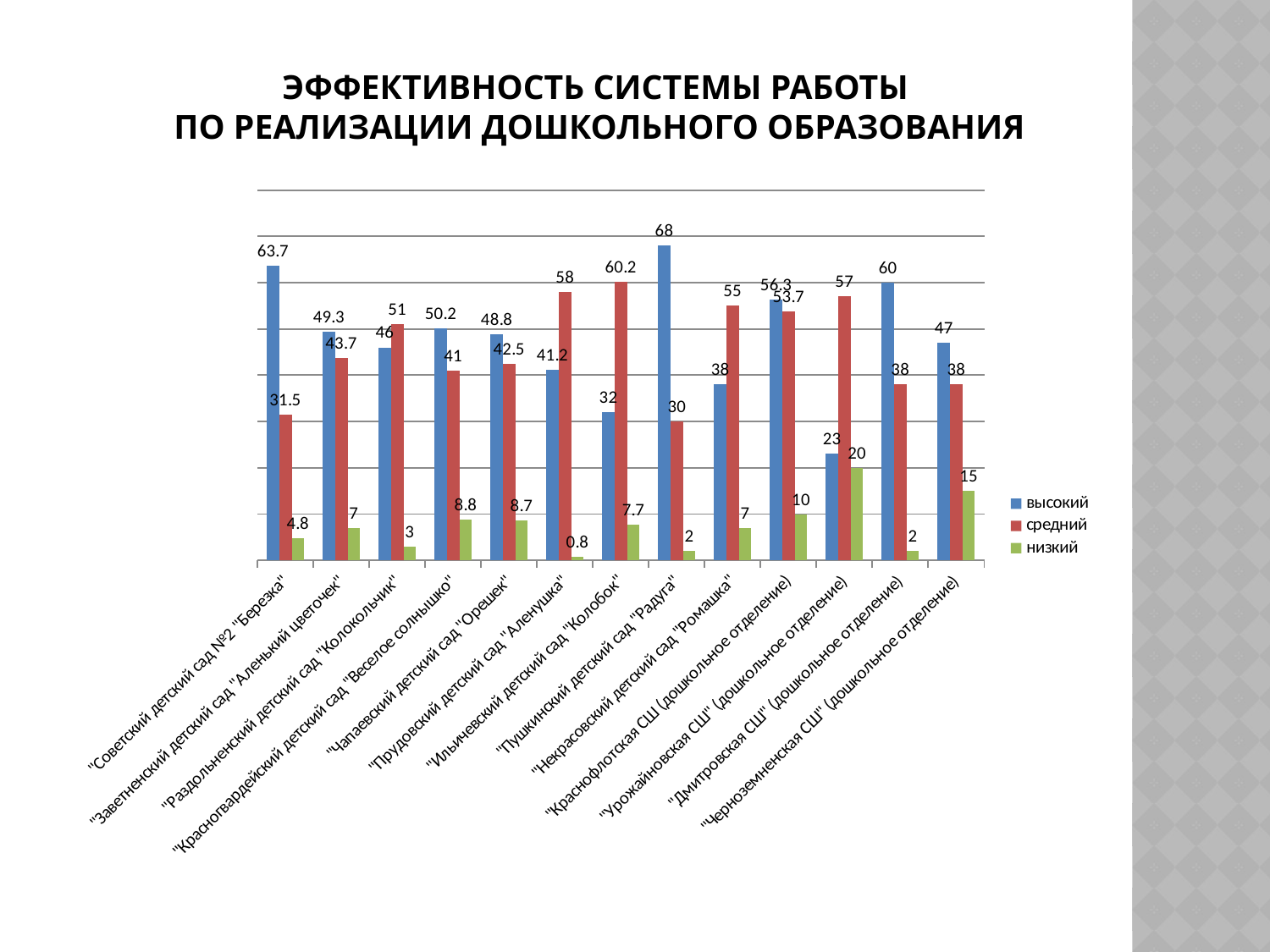
What is the value of the "высокий" series for "Советский детский сад №2 "Березка""? 63.7 What kind of chart is shown on the slide? Bar chart Which category has the lowest value in the "низкий" series? "Прудовский детский сад "Аленушка"" What is the difference between the "средний" values for "Прудовский детский сад "Аленушка"" and "Дмитровская СШ (дошкольное отделение)"? 20 Which category has the lowest value in the "высокий" series? "Урожайновская СШ (дошкольное отделение)" How many series does the legend list? 3 How many categories are shown on the x axis of the chart? 13 What is the difference between the "высокий" and "средний" values for "Пушкинский детский сад "Радуга""? 38 What is the value of the "средний" series for "Ильичевский детский сад "Колобок""? 60.2 What is the value of the "низкий" series for "Урожайновская СШ (дошкольное отделение)"? 20 Which category has the highest value in the "высокий" series? "Пушкинский детский сад "Радуга"" Which is larger for "Раздольненский детский сад "Колокольчик"": the "высокий" value or the "средний" value? средний